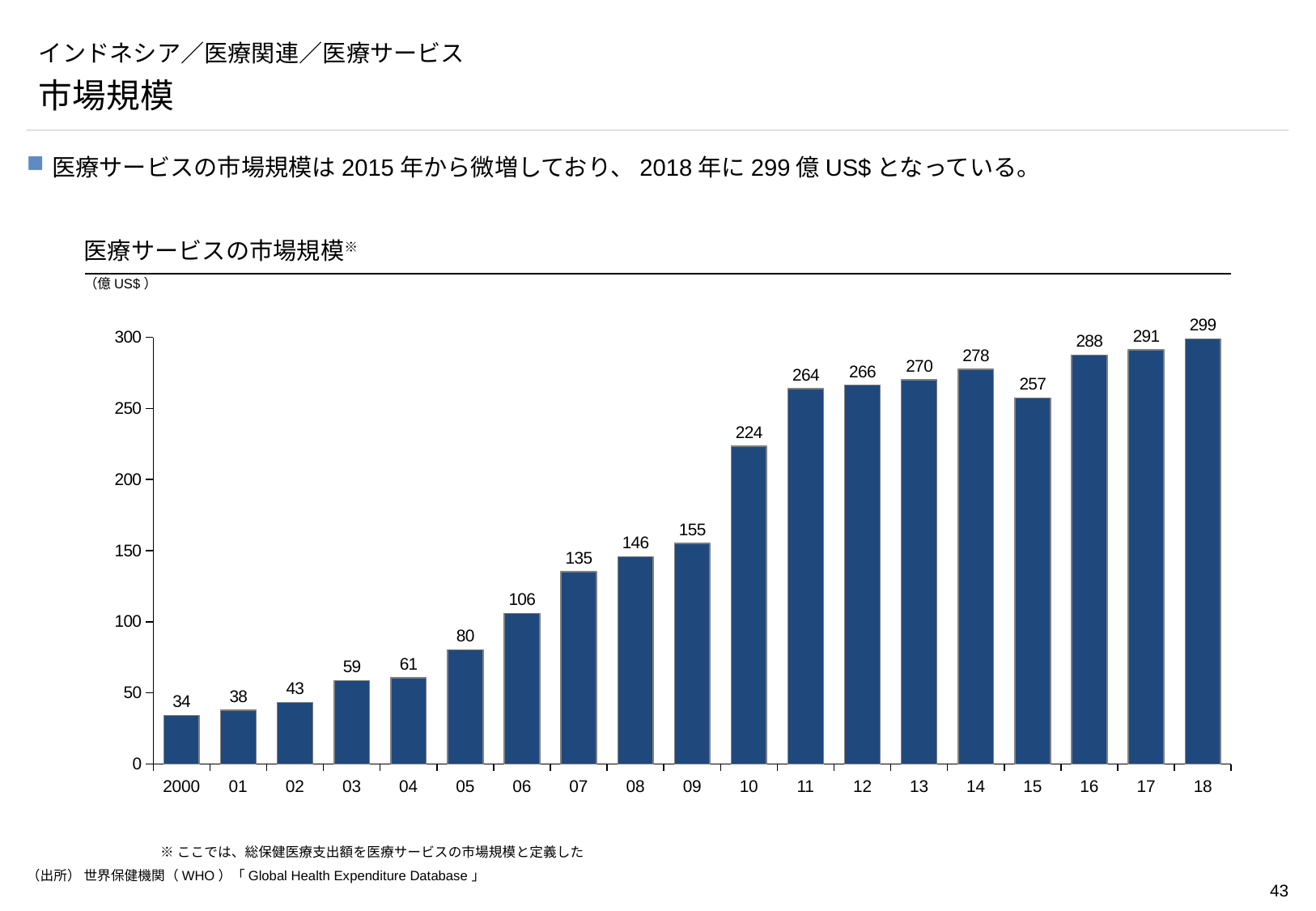
How many years are shown on the x axis? 19 Is the value for 2009 greater or less than 150? greater What is the difference between the values for 2018 and 2015? 42 What is the value for 2018? 299 Which year has the lowest value? 2000 Which year has the highest value? 18 What is the value for 2000? 34 What kind of chart is this? bar chart What is the value for 2010? 224 Which is larger, the value for 2014 or the value for 2015? 14 Do the values generally rise or fall from 2000 to 2018? rise What unit is shown for the y axis? 億US$